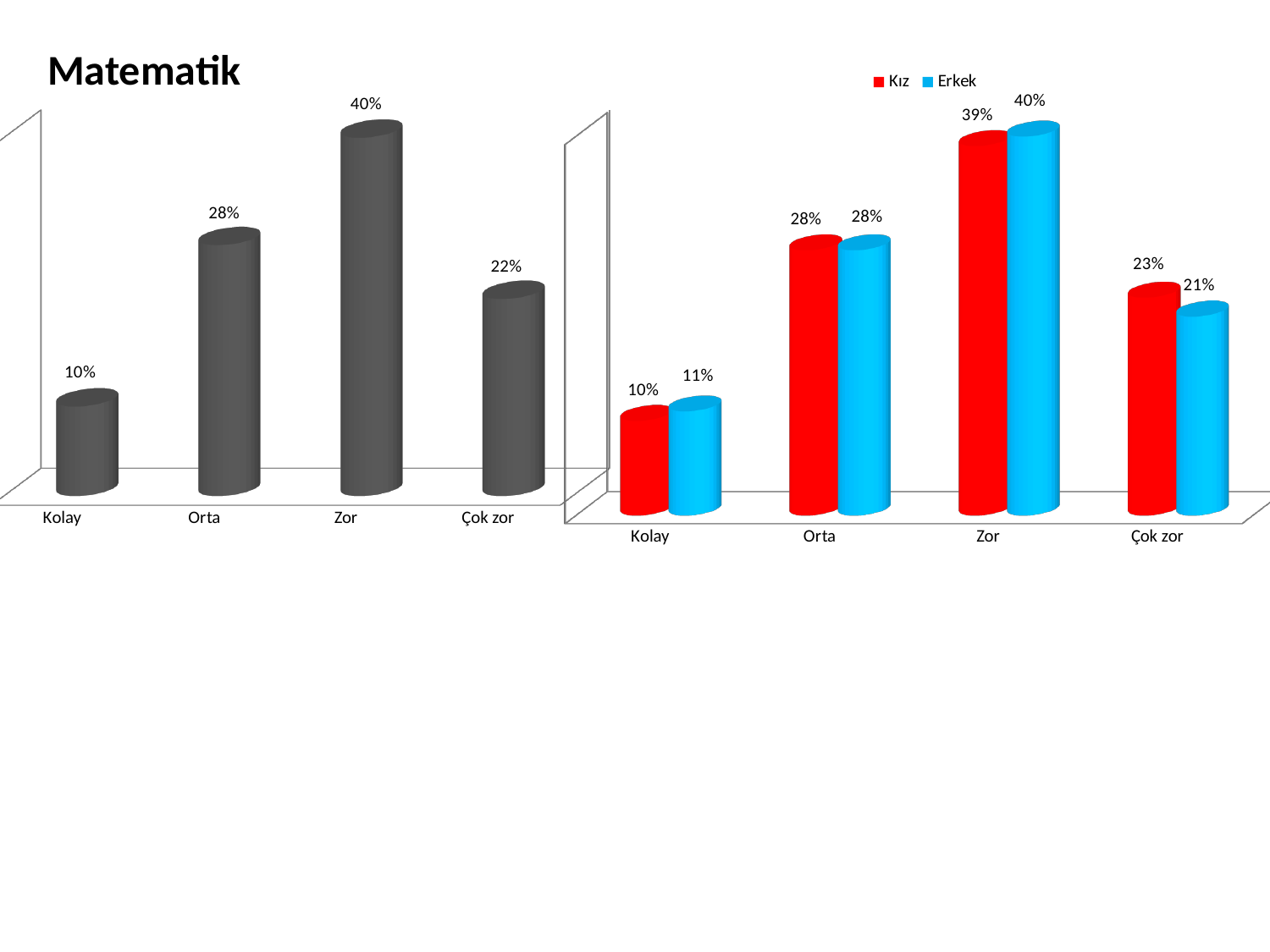
In the right chart, which series is shown in red? Kız In the right chart, what is the difference between the Kız and Erkek values for Çok zor? 2% In the right chart, what is the Erkek value for Çok zor? 21% In the left chart, what is the difference between the values for Zor and Çok zor? 18% In the left chart, how many categories are shown? 4 What kind of chart is the right chart? Bar chart In the right chart, how many series does the legend list? 2 In the left chart, what is the value for Zor? 40% In the right chart, which category has the highest Erkek value? Zor In the right chart, which is larger for Kolay: the Kız value or the Erkek value? Erkek In the right chart, what is the Kız value for Zor? 39% In the left chart, which category has the lowest value? Kolay